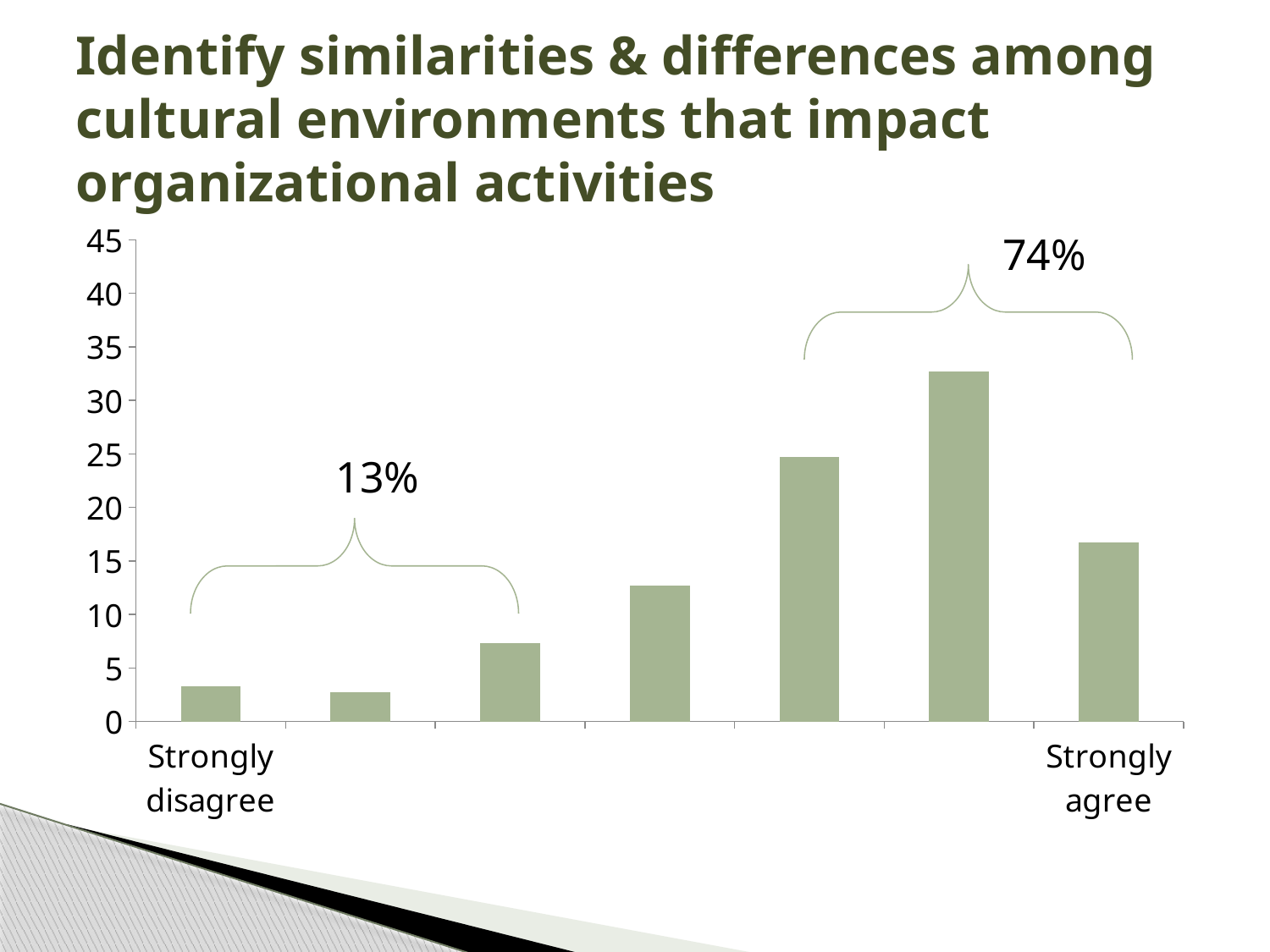
Is the value for Strongly agree greater or less than 15? greater Is the value for Strongly disagree greater or less than 5? less What is the label of the leftmost category on the x axis? Strongly disagree What is the highest value shown on the vertical axis? 45 How many bars are plotted in the chart? 7 Is the value of the middle (fourth) bar greater or less than 10? greater What percentage is shown above the bracket spanning the three leftmost bars? 13% What percentage is shown above the bracket spanning the three rightmost bars? 74% Which bar is the tallest in the chart? the sixth bar from the left What kind of chart is shown on the slide? bar chart Which is larger, the value for Strongly agree or the value for Strongly disagree? Strongly agree